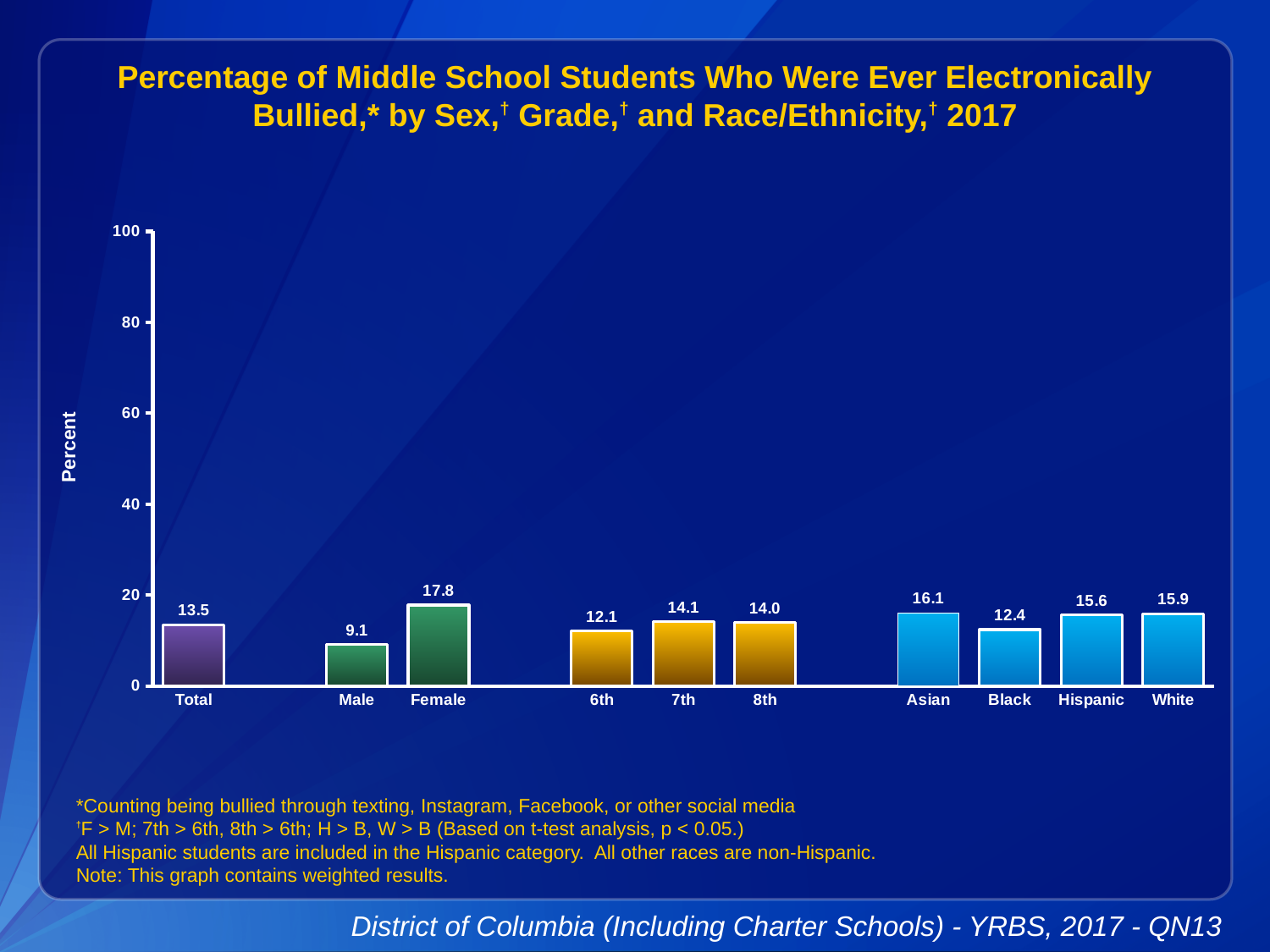
Do the values rise or fall from 6th to 7th grade? rise Is the value for Female greater or less than 20? less What is the value for Female? 17.8 What is the value for Total? 13.5 What kind of chart is this? bar chart Which is larger, the value for Asian or the value for Black? Asian What is the label on the y axis? Percent What is the value for Black? 12.4 Which category has the lowest value? Male How many categories are shown on the x axis? 10 What is the difference between the Female and Male values? 8.7 Which category has the highest value? Female